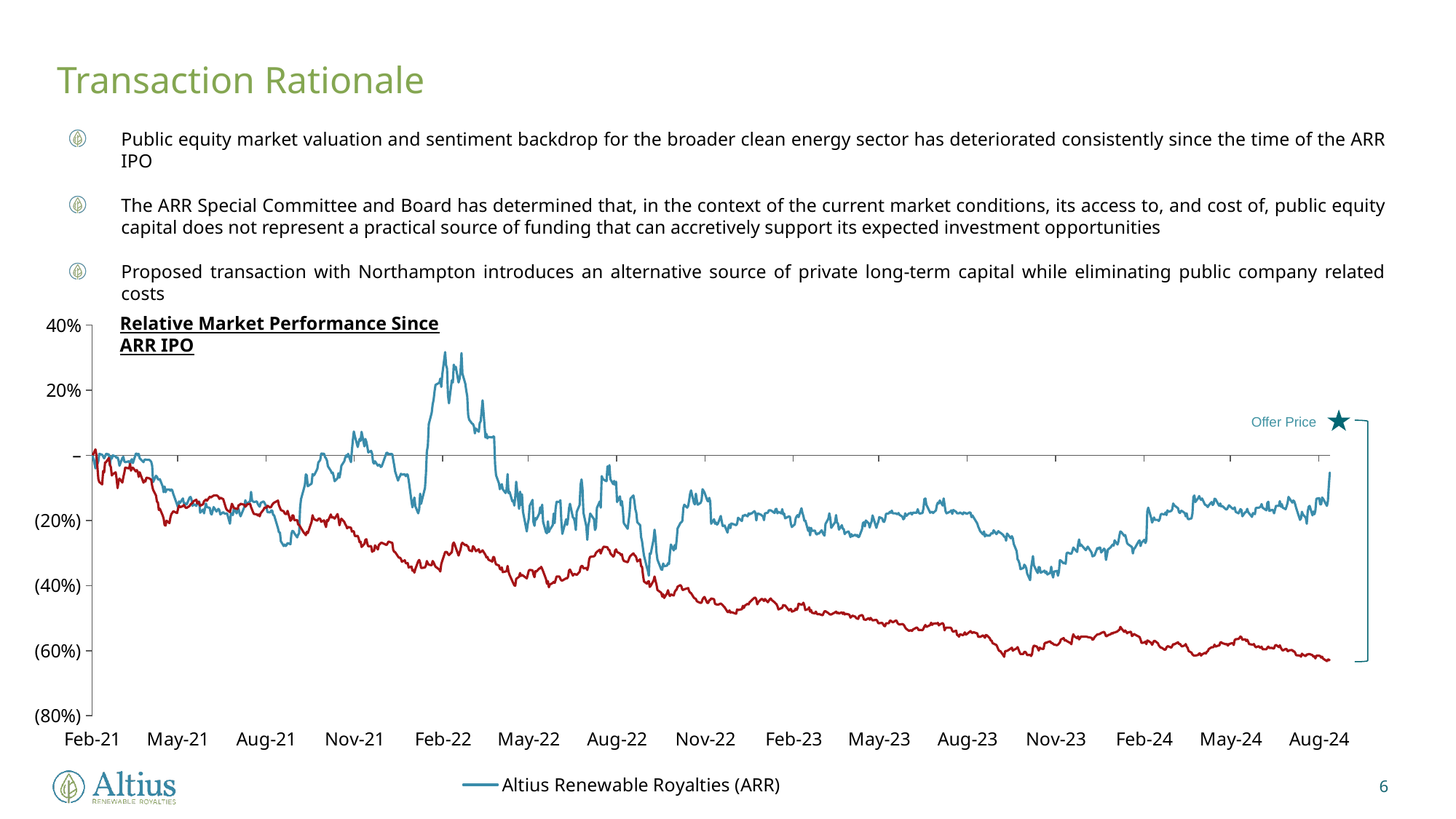
How many date labels are shown along the x axis? 15 Is the value of the Altius Renewable Royalties (ARR) line at Nov-23 greater or less than (20%)? less How many series does the chart legend list? 1 Is the value of the red line at Feb-23 greater or less than (40%)? less What is the title of the chart? Relative Market Performance Since ARR IPO What kind of chart is shown on the slide? line chart Which series is named in the chart legend? Altius Renewable Royalties (ARR) Is the peak value of the Altius Renewable Royalties (ARR) line around Feb-22 greater or less than 20%? greater Does the red line generally rise or fall from Feb-21 to Aug-24? fall At Feb-23, which line is lower, the blue Altius Renewable Royalties (ARR) line or the red line? the red line At Aug-24, which line is higher, the blue Altius Renewable Royalties (ARR) line or the red line? the blue Altius Renewable Royalties (ARR) line